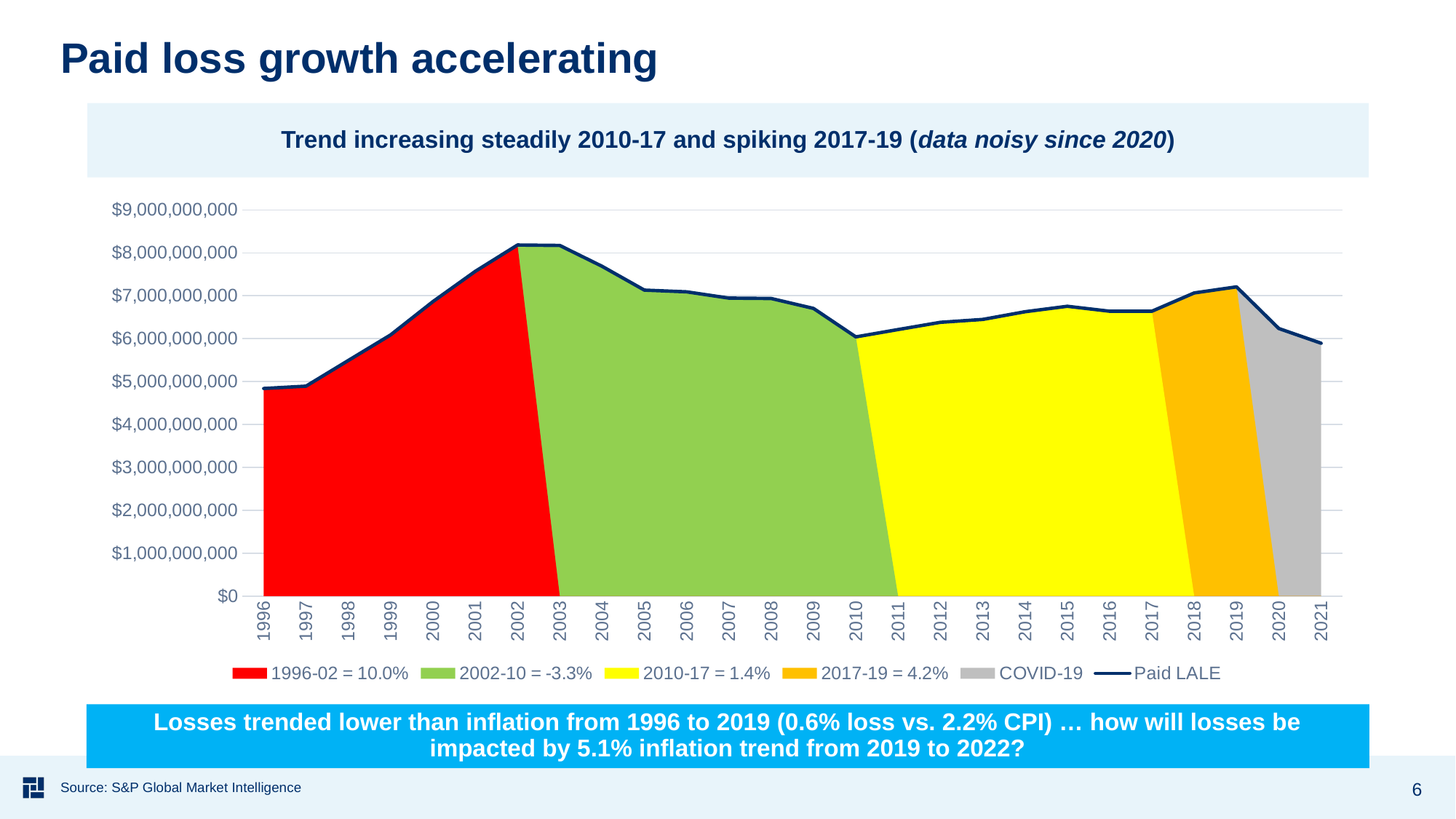
Is the Paid LALE value for 2019 greater or less than $7,000,000,000? greater Is the Paid LALE value for 2000 greater or less than $6,000,000,000? greater Do Paid LALE values rise or fall from 2003 to 2010? fall Which year has the higher Paid LALE value, 2002 or 2010? 2002 What kind of chart is shown on the slide? area chart Is the Paid LALE value for 2009 greater or less than $7,000,000,000? less How many entries does the legend list? 6 What colour is the area labelled COVID-19 in the legend? grey Do Paid LALE values rise or fall from 2010 to 2017? rise How many years are plotted along the x axis? 26